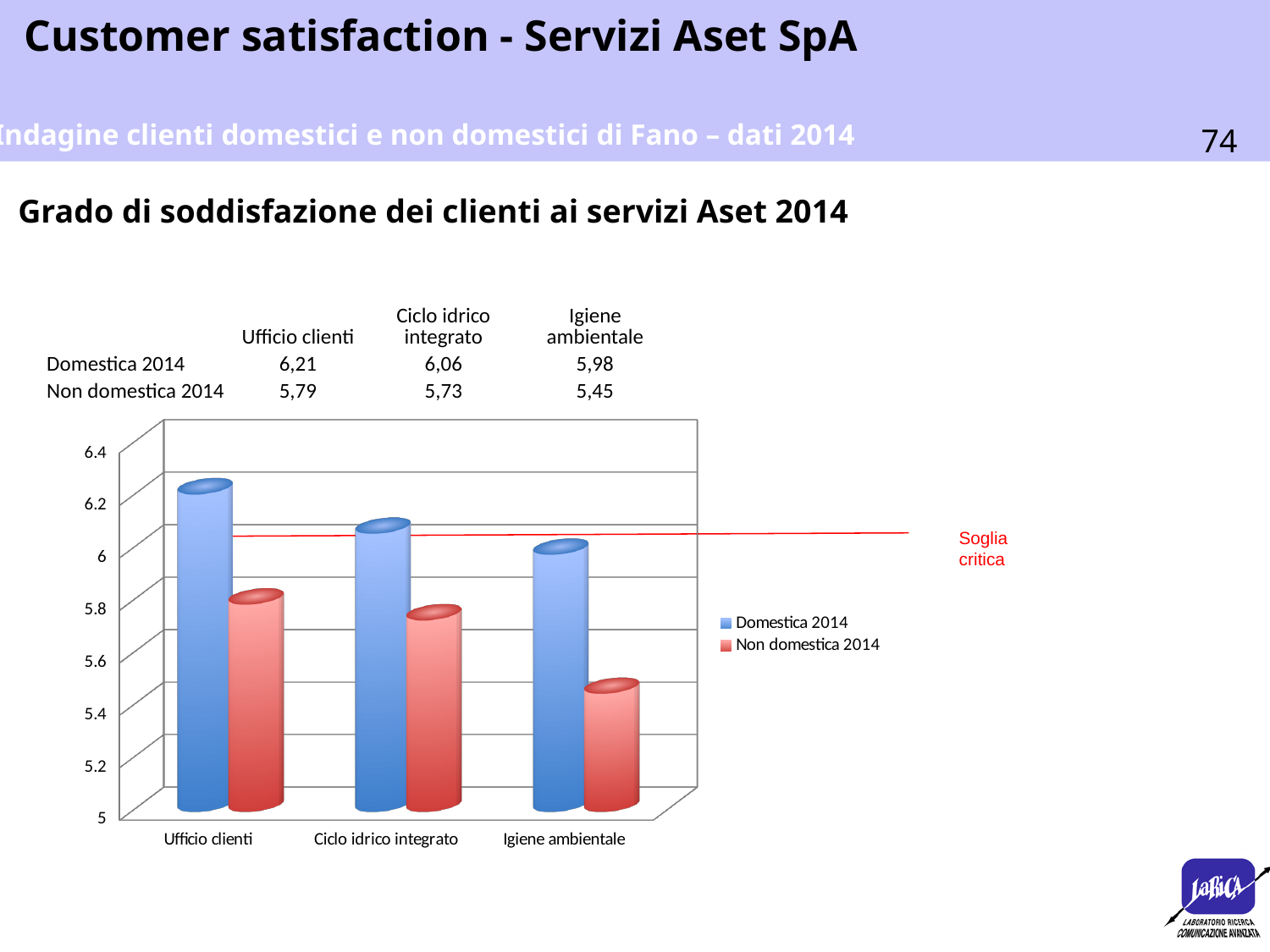
What is the value for Non domestica 2014 in the Igiene ambientale category? 5,45 Which category has the highest value for Domestica 2014? Ufficio clienti Is the value for Non domestica 2014 in Ufficio clienti greater or less than 6? less Which category has the lowest value for Non domestica 2014? Igiene ambientale What is the label of the red horizontal line drawn across the chart? Soglia critica What is the value for Domestica 2014 in the Ufficio clienti category? 6,21 What is the difference between Domestica 2014 and Non domestica 2014 for Igiene ambientale? 0,53 What is the value for Non domestica 2014 in the Ciclo idrico integrato category? 5,73 Which is larger for Ciclo idrico integrato: Domestica 2014 or Non domestica 2014? Domestica 2014 How many categories are shown on the x axis of the chart? 3 How many series does the chart legend list? 2 What kind of chart is shown on the slide? Bar chart